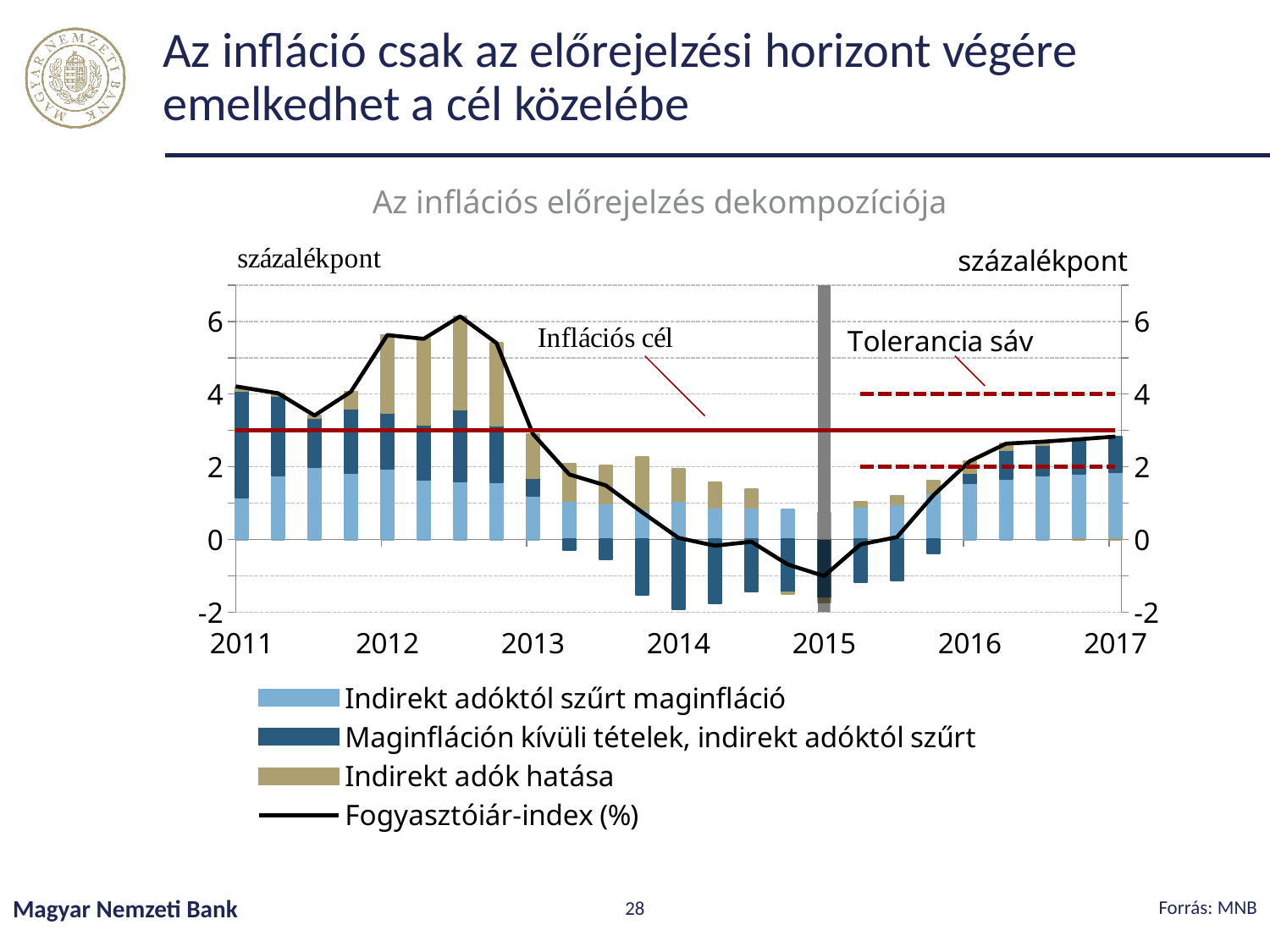
At what value on the axis is the lower dashed line of the Tolerancia sáv drawn? 2 Is the Fogyasztóiár-index (%) line higher at 2012 or at 2015? 2012 How many series does the legend list? 4 Does the Fogyasztóiár-index (%) line rise or fall between 2012 and 2015? fall Is the value of the Fogyasztóiár-index (%) line at 2012 greater or less than 4? greater Is the value of the Fogyasztóiár-index (%) line at 2017 greater or less than 2? greater At what value on the axis is the upper dashed line of the Tolerancia sáv drawn? 4 Is the value of the Fogyasztóiár-index (%) line at 2015 greater or less than 0? less What unit is shown on the vertical axis of the chart? százalékpont What is the title of the chart? Az inflációs előrejelzés dekompozíciója What kind of chart is shown on the slide? Bar chart with a line How many year labels are shown on the x axis? 7